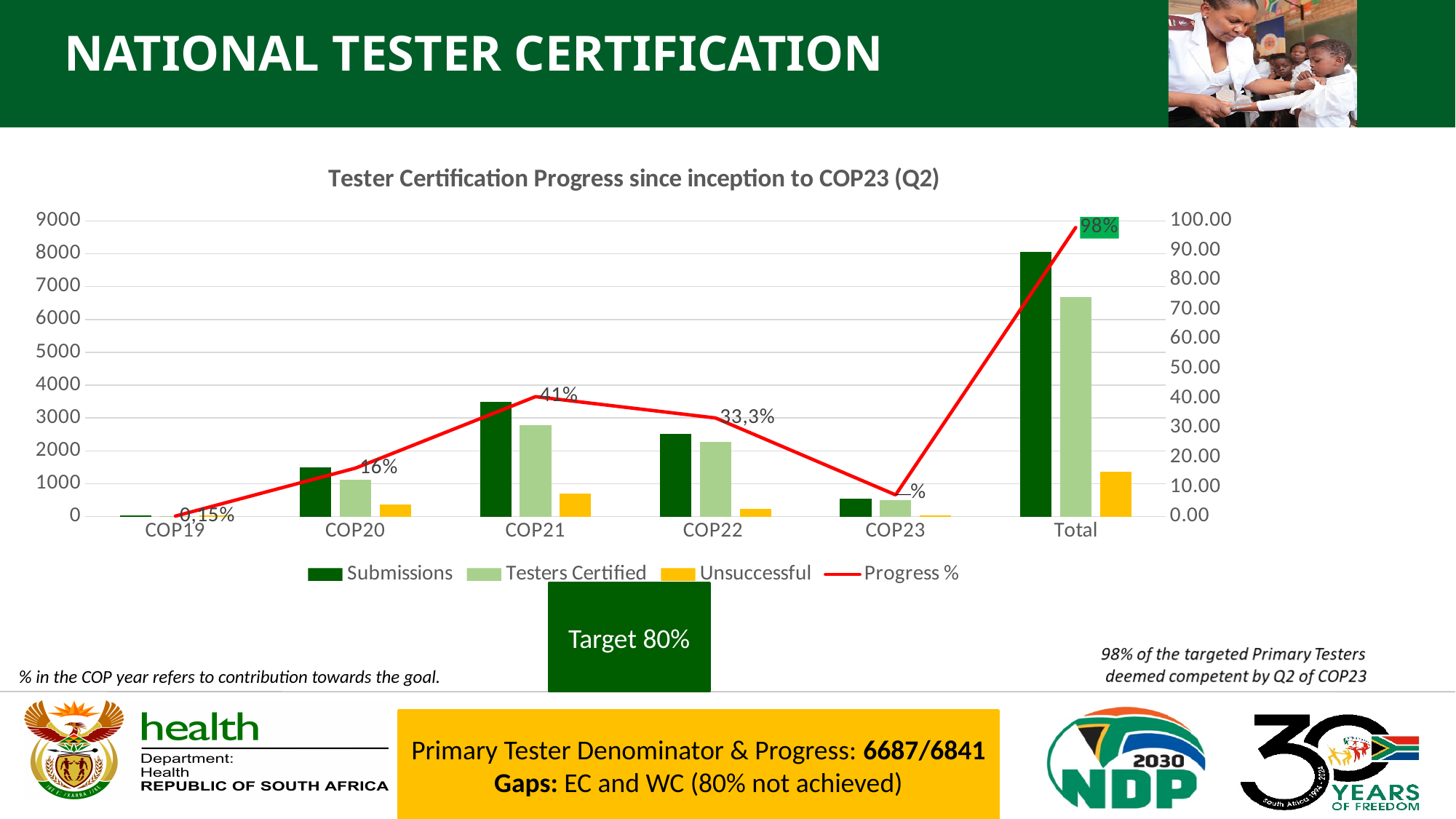
What is the difference between the Progress % values for COP21 and COP20? 25% Is the Unsuccessful value for COP21 greater or less than 1000? less What is the Progress % value shown for COP21? 41% Is the Submissions value for COP21 greater or less than 3000? greater Which category has the highest Progress % value? Total Which category has the lowest Progress % value? COP19 How many series does the legend list? 4 What is the Progress % value shown for Total? 98% How many categories are shown on the x axis? 6 What is the Progress % value shown for COP22? 33,3% Which has the larger Progress % value, COP21 or COP22? COP21 What is the Progress % value shown for COP19? 0,15%